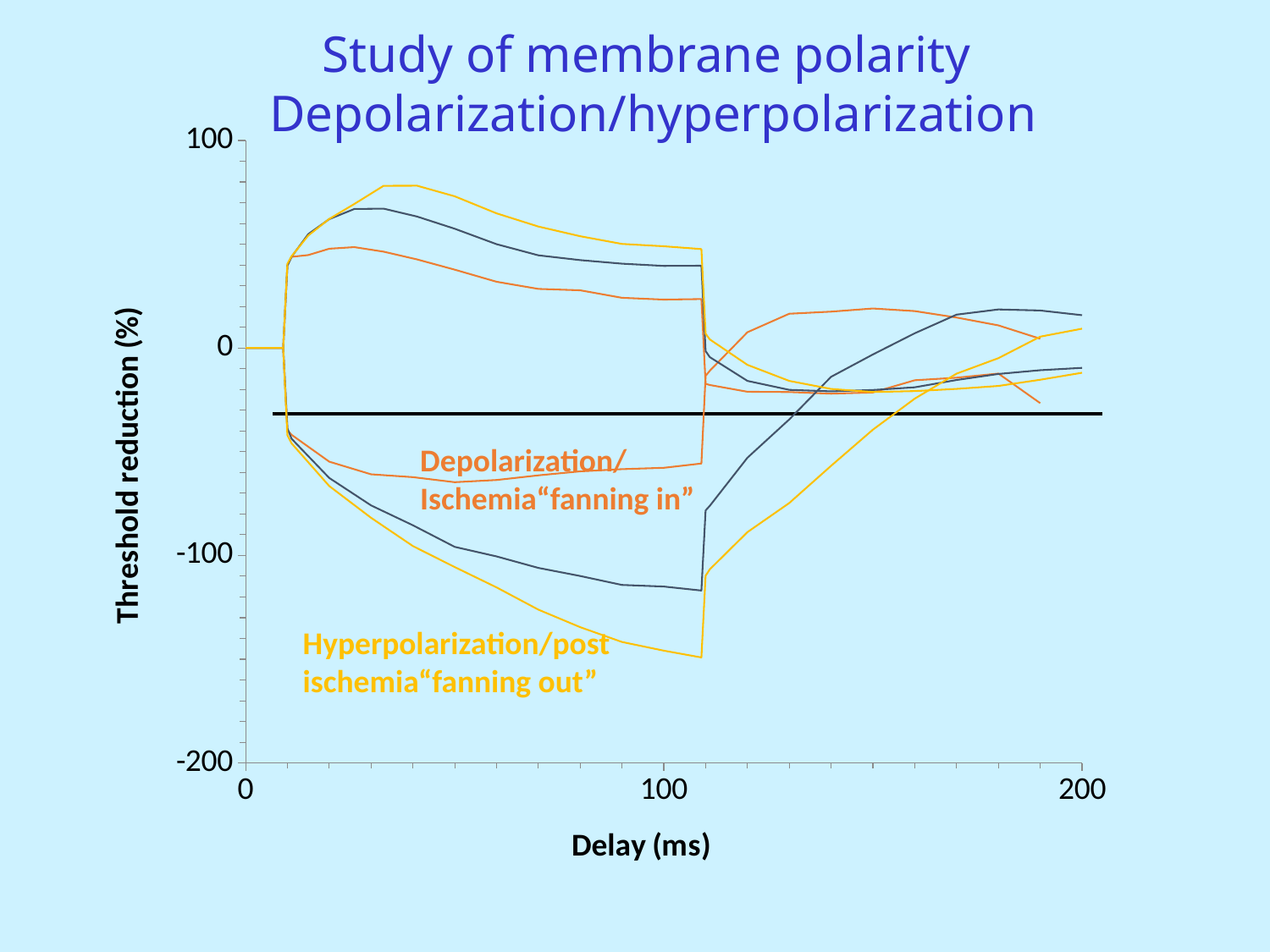
Is the horizontal black line drawn at a value greater or less than 0? less At a delay of 100 ms, which is lower: the lower yellow line or the lower dark blue line? the lower yellow line What kind of chart is shown on the slide? line chart Is the lowest point of the yellow 'Hyperpolarization/post ischemia' line greater or less than -100? less What is the title of the y axis? Threshold reduction (%) At a delay of 100 ms, which is higher: the upper yellow line or the upper orange line? the upper yellow line Between a delay of about 10 ms and 100 ms, does the lower yellow line rise or fall? fall What is the title of the x axis? Delay (ms) Is the highest point of the upper yellow line greater or less than 50? greater Between a delay of about 40 ms and 100 ms, does the upper yellow line rise or fall? fall How many labelled tick marks are on the x axis? 3